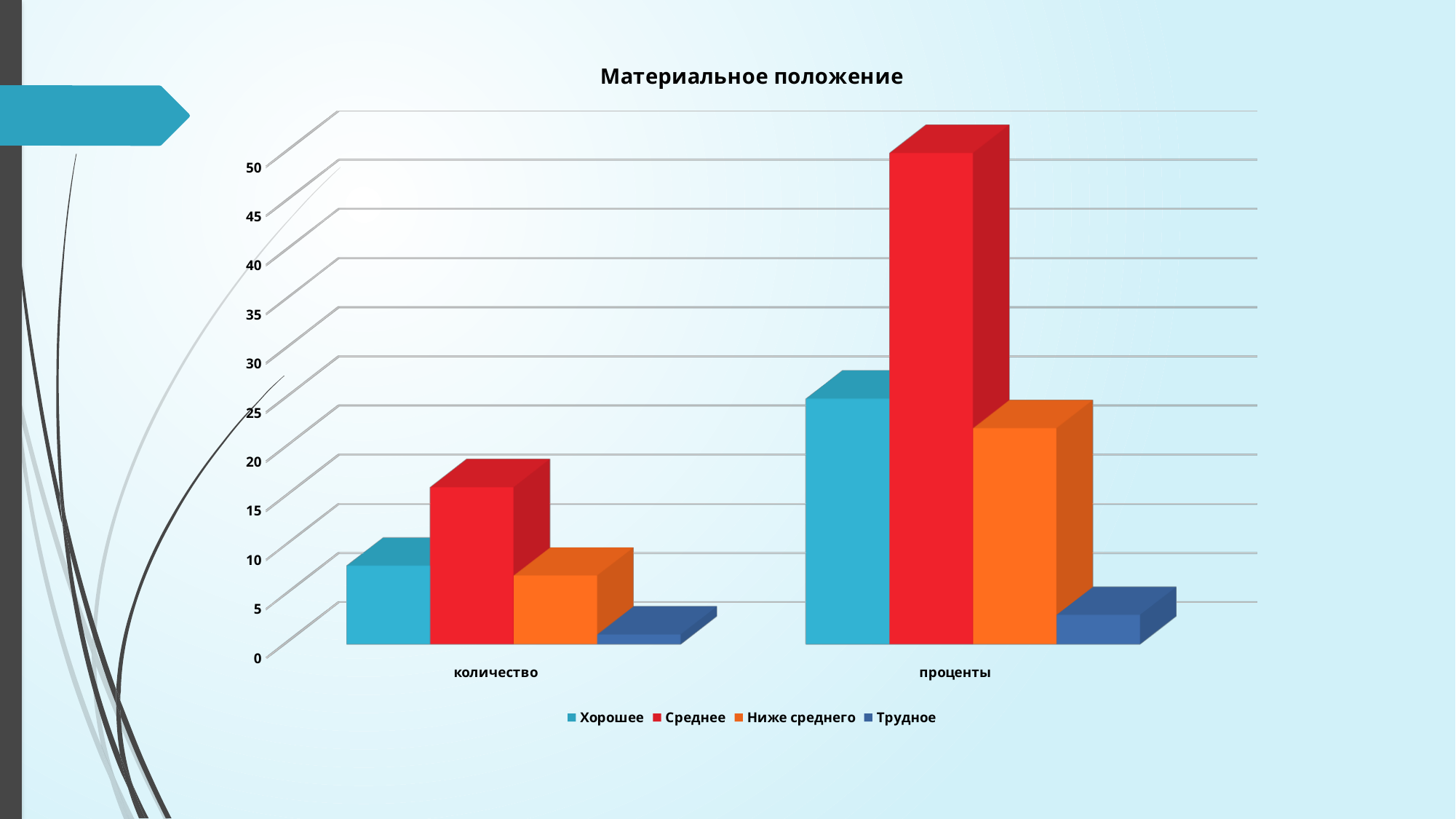
Which series has the lowest value in the проценты category? Трудное Is the value for Трудное in the проценты category greater or less than 10? less What kind of chart is shown on the slide? bar chart Is the value for Среднее in the проценты category greater or less than 40? greater Which series has the lowest value in the количество category? Трудное Is the value for Среднее in the количество category greater or less than 10? greater How many series does the legend list? 4 Which is larger: the value for Среднее in проценты or the value for Среднее in количество? Среднее in проценты Which series has the highest value in the проценты category? Среднее How many categories are shown on the x axis? 2 Which series has the highest value in the количество category? Среднее What is the title of the chart? Материальное положение